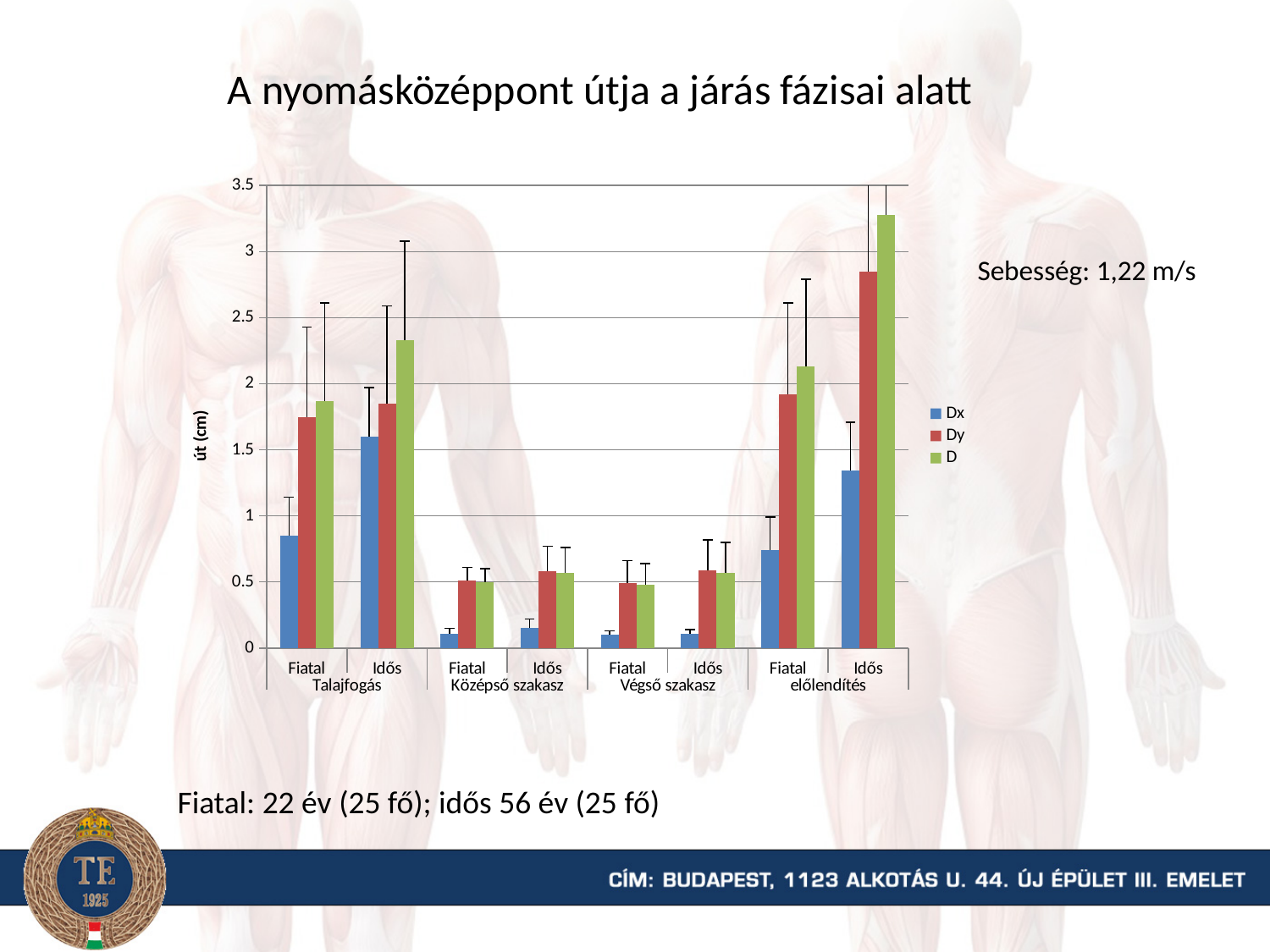
Is the Dy value for Idős in előlendítés greater or less than 2.5? greater How many Fiatal/Idős category groups are plotted along the x axis? 8 What is the label of the vertical axis? út (cm) How many series does the legend list? 3 What kind of chart is shown on the slide? bar chart What are the series names listed in the legend? Dx, Dy, D Is the Dx value for Fiatal in Talajfogás greater or less than 1? less In which gait phase does the D series reach its highest value? előlendítés Is the D value for Idős in előlendítés greater or less than 3? greater In Talajfogás, which group has the larger Dx value, Fiatal or Idős? Idős Which series has the tallest bar in the Idős group of előlendítés? D